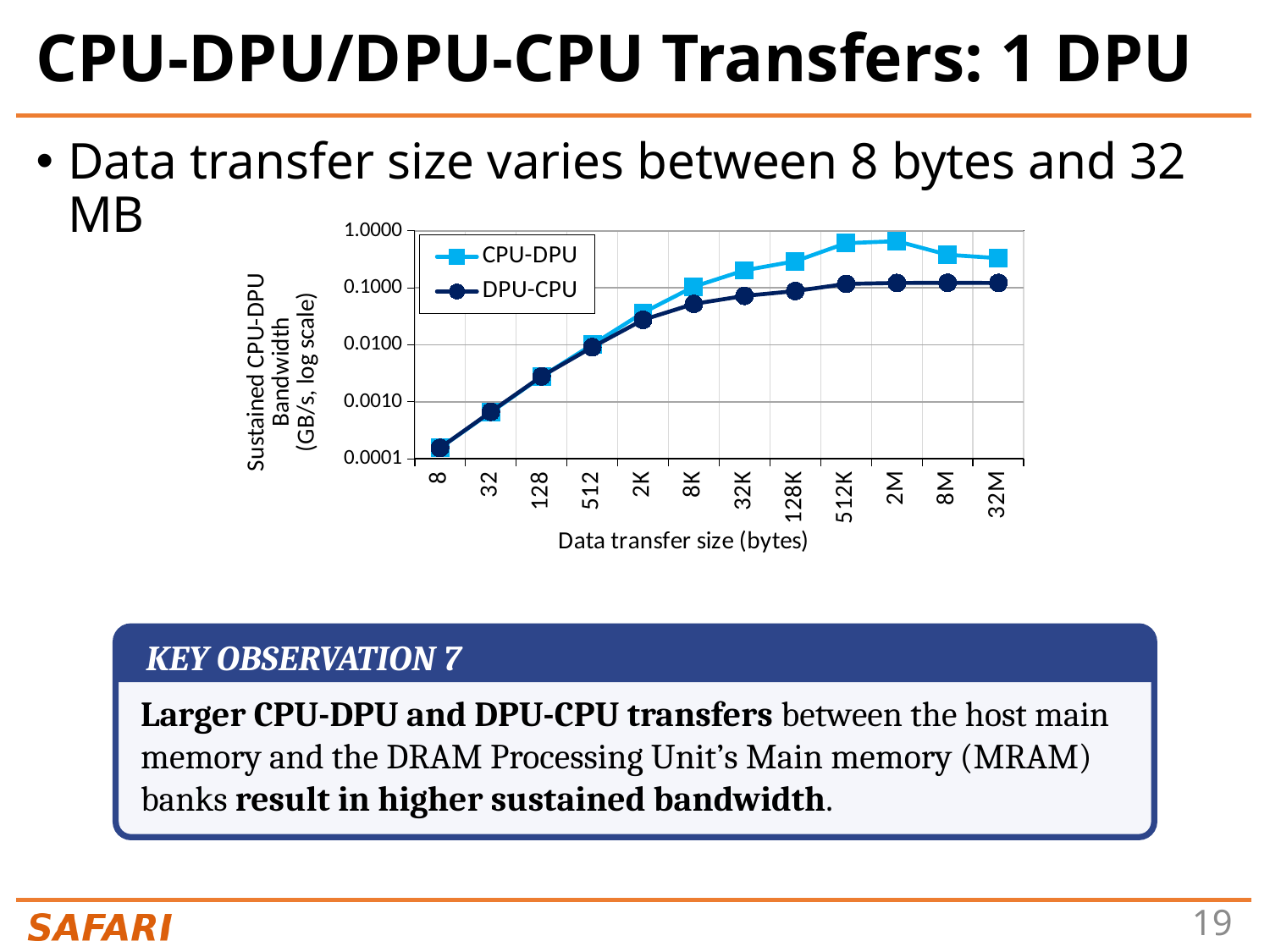
Is the DPU-CPU value at 2K greater or less than 0.0100? greater Which two series are listed in the legend? CPU-DPU and DPU-CPU How many series does the legend list? 2 What is the title of the x axis? Data transfer size (bytes) Is the CPU-DPU value at 512K greater or less than 1.0000? less Is the CPU-DPU value at 2M greater or less than 0.1000? greater Does the CPU-DPU bandwidth generally rise or fall as the data transfer size increases from 8 bytes to 2M? rise What kind of chart is shown on the slide? line chart How many data transfer sizes are plotted along the x axis? 12 At a data transfer size of 2M, which series has the higher sustained bandwidth, CPU-DPU or DPU-CPU? CPU-DPU